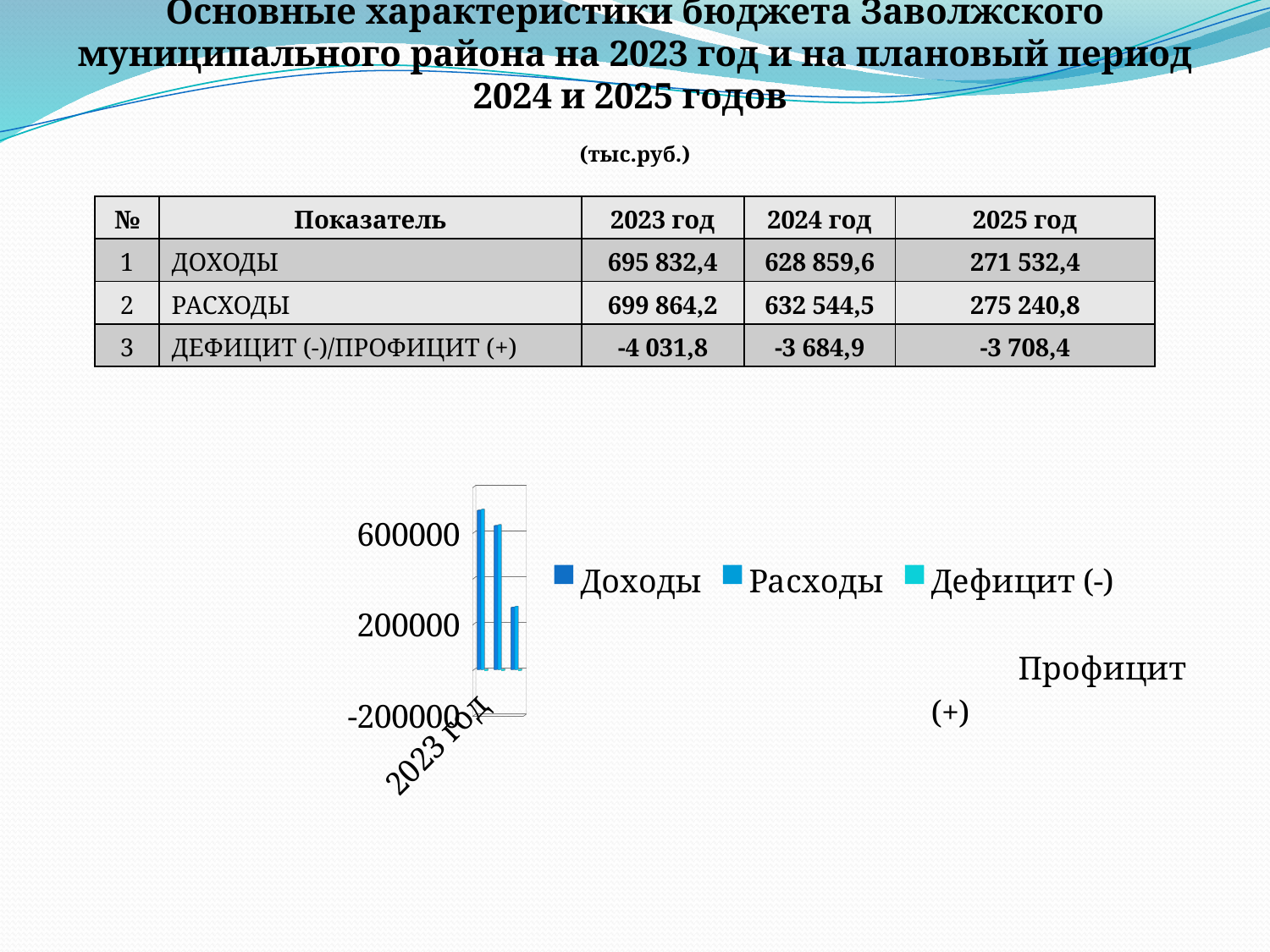
Which category label is readable on the chart's horizontal axis? 2023 год What is the highest value labelled on the chart's vertical axis? 600000 What is the first series listed in the chart legend? Доходы What is the lowest value labelled on the chart's vertical axis? -200000 Is the value of the tallest bar in the chart greater or less than 200000? greater What is the second series listed in the chart legend? Расходы Do the bars in the chart rise or fall from left to right? fall What kind of chart is shown on the slide? bar chart How many series does the chart legend list? 3